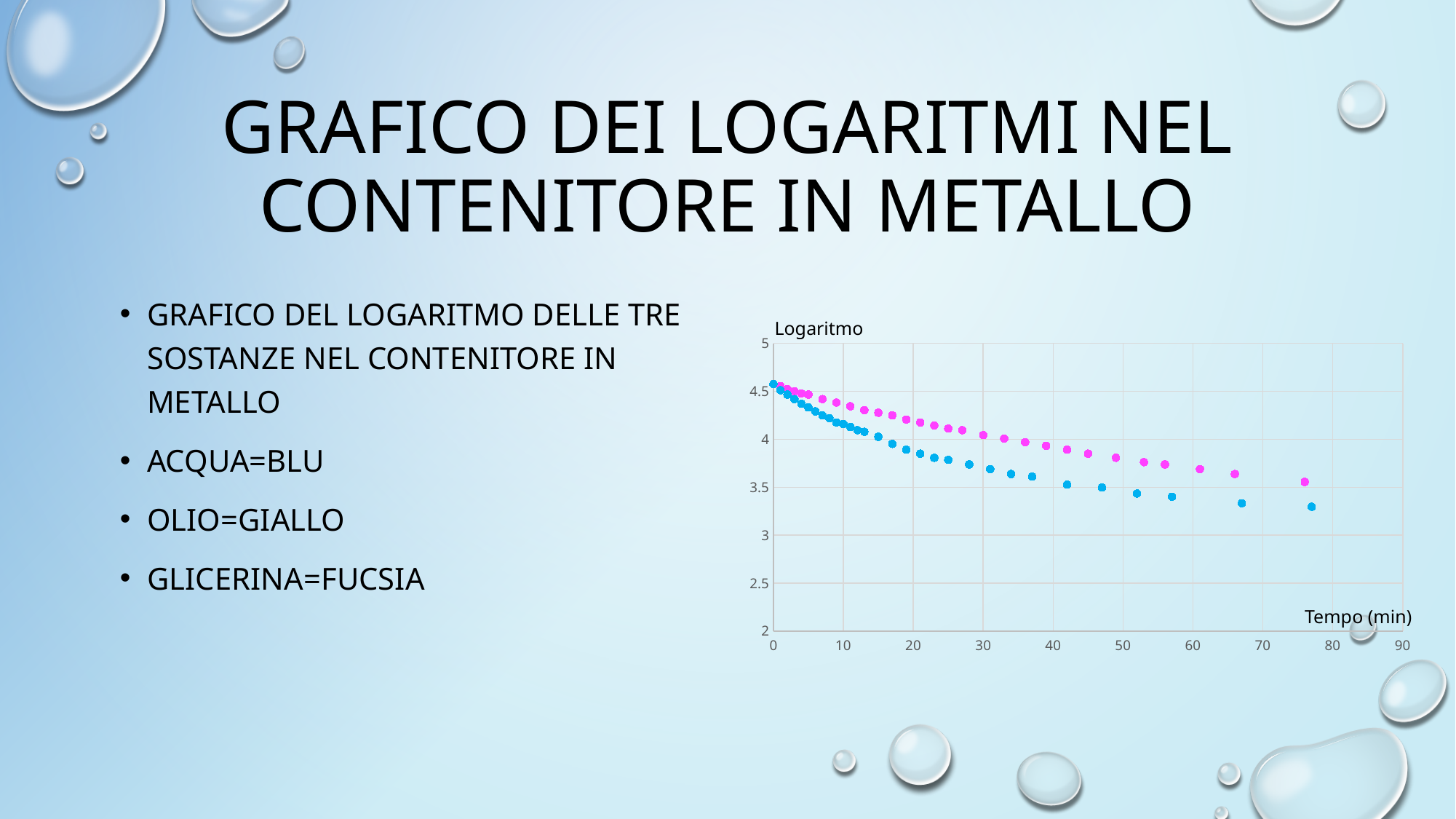
What is the highest tick value shown on the horizontal axis? 90 What is the label of the horizontal axis of the chart? Tempo (min) Is the value of the fuchsia series at its last point (around 77 minutes) greater or less than 3.5? greater Is the value of the blue series at its last point (around 77 minutes) greater or less than 3.5? less Is the value of the blue series at around 20 minutes greater or less than 4? less What is the title shown above the vertical axis of the chart? Logaritmo What kind of chart is shown on the slide? scatter chart Do the plotted values rise or fall as time increases along the x axis? fall At around 50 minutes, which series has the higher logarithm value, the blue or the fuchsia one? fuchsia